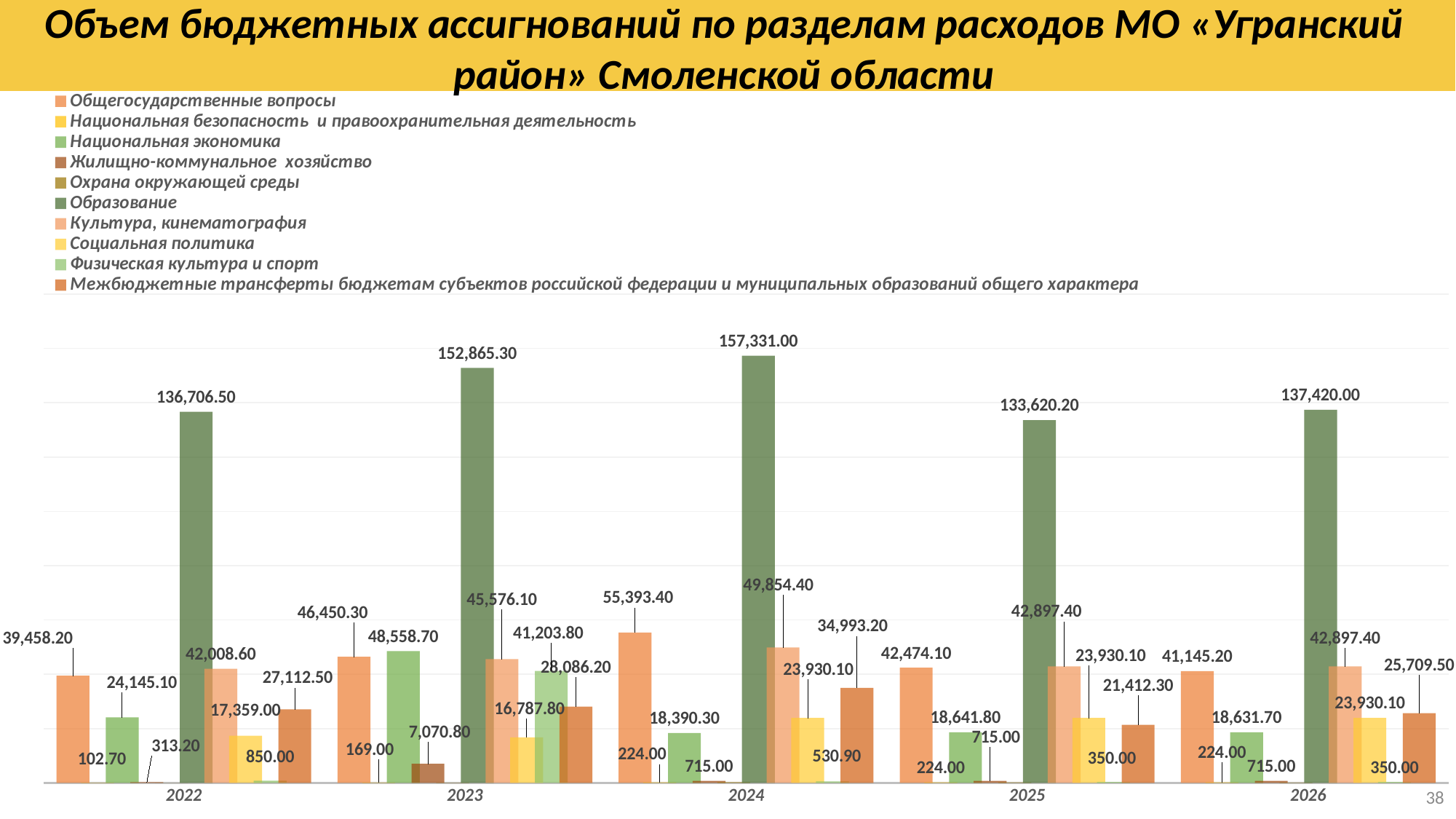
In which year is the value for Образование the highest? 2024 What is the value for Социальная политика in 2022? 17,359.00 What is the value for Межбюджетные трансферты бюджетам субъектов российской федерации и муниципальных образований общего характера in 2026? 25,709.50 What kind of chart is shown on the slide? Bar chart How many series does the legend list? 10 Which is larger in 2024: Общегосударственные вопросы or Культура, кинематография? Общегосударственные вопросы What is the difference between the Образование values for 2024 and 2023? 4,465.70 In which year is the value for Образование the lowest? 2025 What is the value for Национальная экономика in 2023? 48,558.70 What is the value for Общегосударственные вопросы in 2022? 39,458.20 What is the value for Образование in 2024? 157,331.00 How many years are shown on the x axis? 5